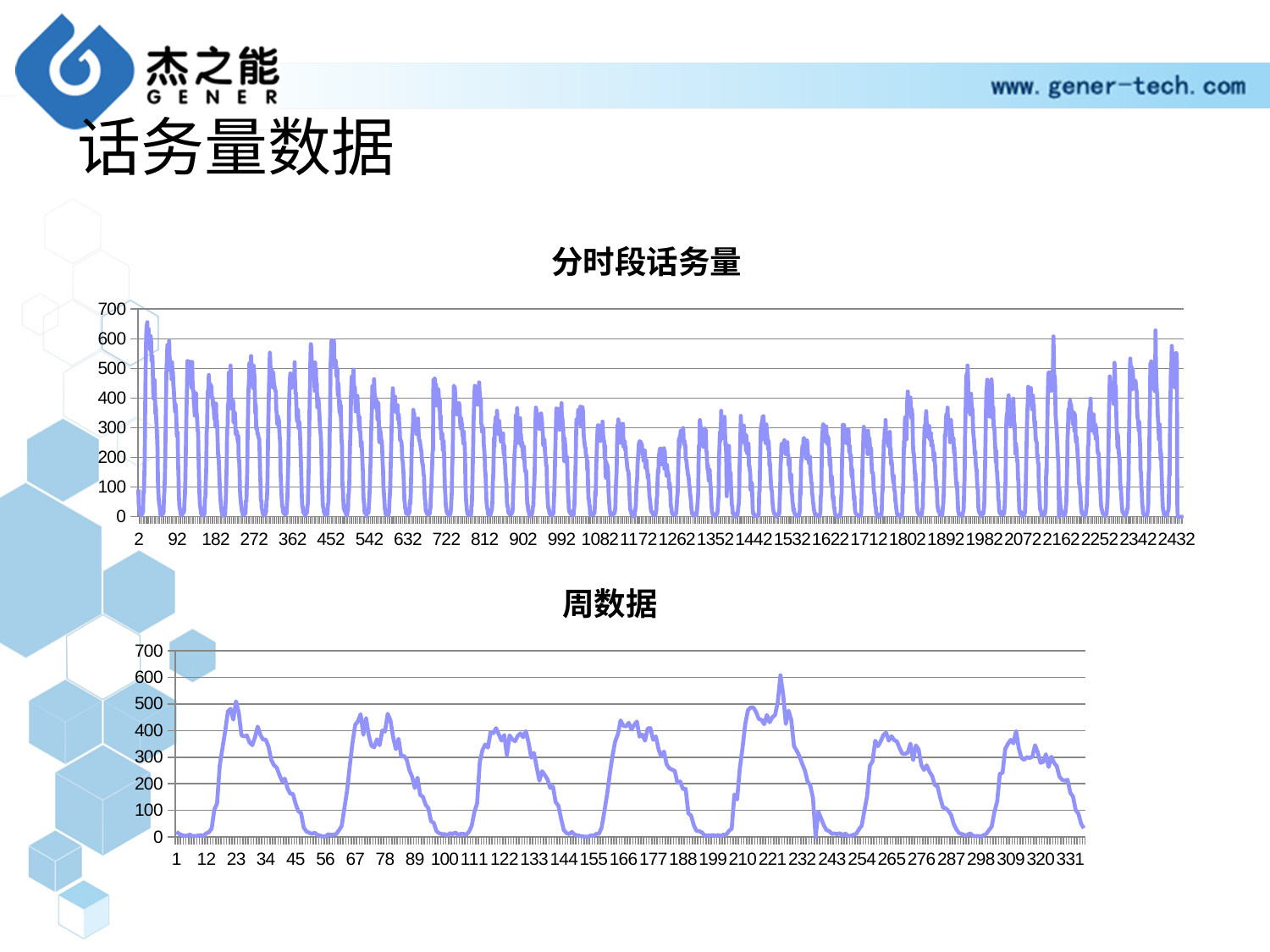
In the 分时段话务量 chart, is the highest peak near the start of the series greater or less than 600? greater What is the title of the top chart on the slide? 分时段话务量 In the 周数据 chart, how many distinct peaks (cycles) are visible? 7 In the 周数据 chart, does the value rise or fall between x = 221 and x = 243? fall In the 周数据 chart, are the lowest values between the peaks greater or less than 100? less In the 分时段话务量 chart, what is the last label on the x axis? 2432 In the 周数据 chart, what is the last label on the x axis? 331 In the 周数据 chart, is the highest peak (near x = 221) greater or less than 500? greater What kind of chart is the 周数据 chart? line chart What is the title of the bottom chart on the slide? 周数据 What kind of chart is the 分时段话务量 chart? line chart In the 分时段话务量 chart, what is the highest value shown on the y axis? 700